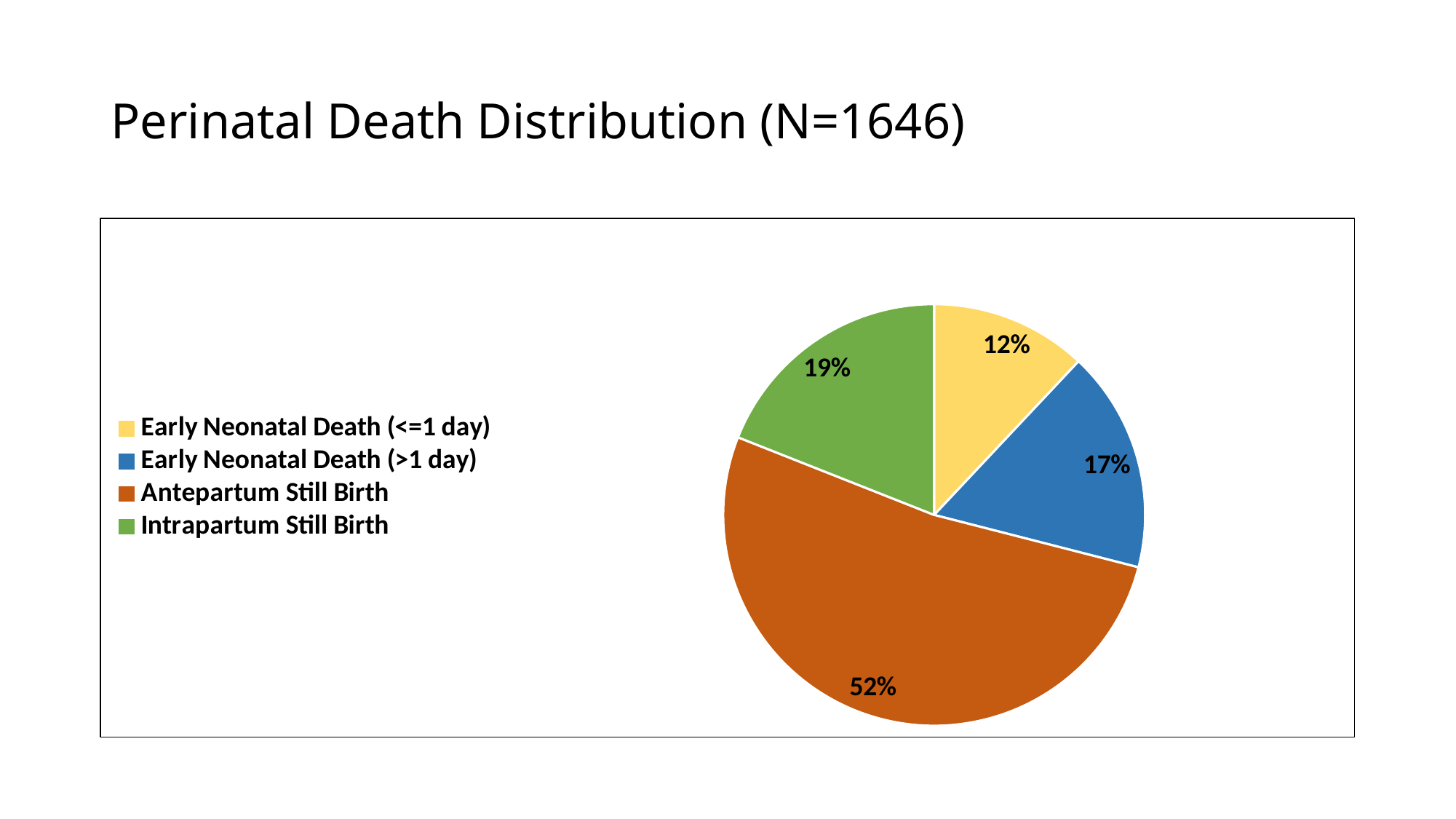
Which is larger: Intrapartum Still Birth or Early Neonatal Death (>1 day)? Intrapartum Still Birth What share of the pie is Intrapartum Still Birth? 19% What colour is the Antepartum Still Birth slice? orange What share of the pie is Early Neonatal Death (<=1 day)? 12% Which category has the smallest slice of the pie? Early Neonatal Death (<=1 day) How many categories does the pie chart have? 4 What share of the pie is Early Neonatal Death (>1 day)? 17% What is the difference in percentage points between Antepartum Still Birth and Intrapartum Still Birth? 33 Which category has the largest slice of the pie? Antepartum Still Birth What is the title of the slide containing the chart? Perinatal Death Distribution (N=1646) What kind of chart is shown on the slide? pie chart